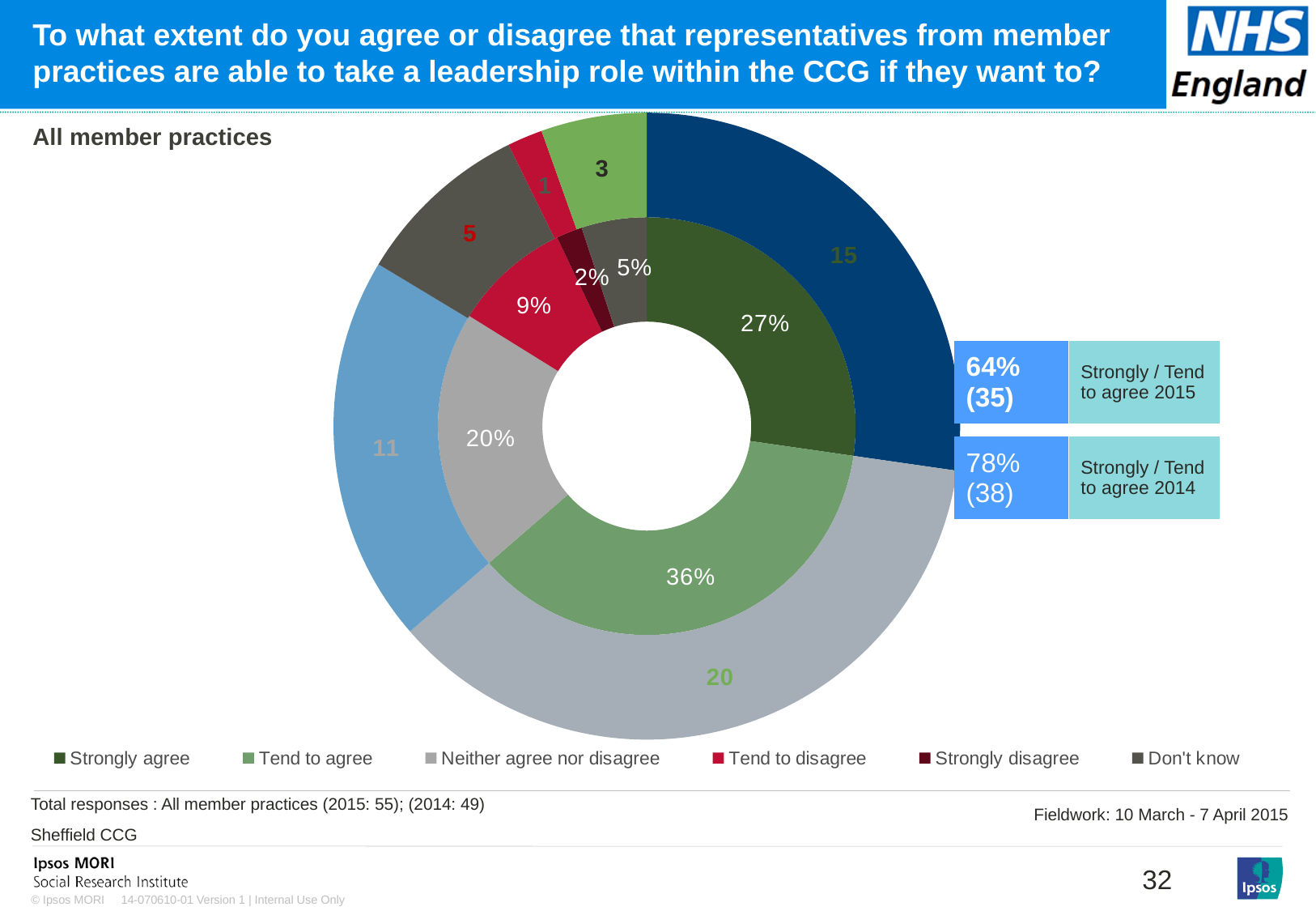
What is the difference in percentage points between 'Tend to agree' and 'Strongly agree'? 9 What percentage of member practices strongly agree, according to the inner ring? 27% Which response category has the smallest share in the inner ring? Strongly disagree What percentage of member practices neither agree nor disagree? 20% How many response categories does the legend list? 6 What percentage of member practices tend to disagree? 9% What percentage of member practices answered 'Don't know'? 5% What was the combined 'Strongly / Tend to agree' percentage in 2014? 78% Which response category has the largest share in the inner ring? Tend to agree Which is larger: the share for 'Neither agree nor disagree' or the share for 'Tend to disagree'? Neither agree nor disagree What kind of chart is shown on the slide? Doughnut chart What percentage of member practices tend to agree, according to the inner ring? 36%